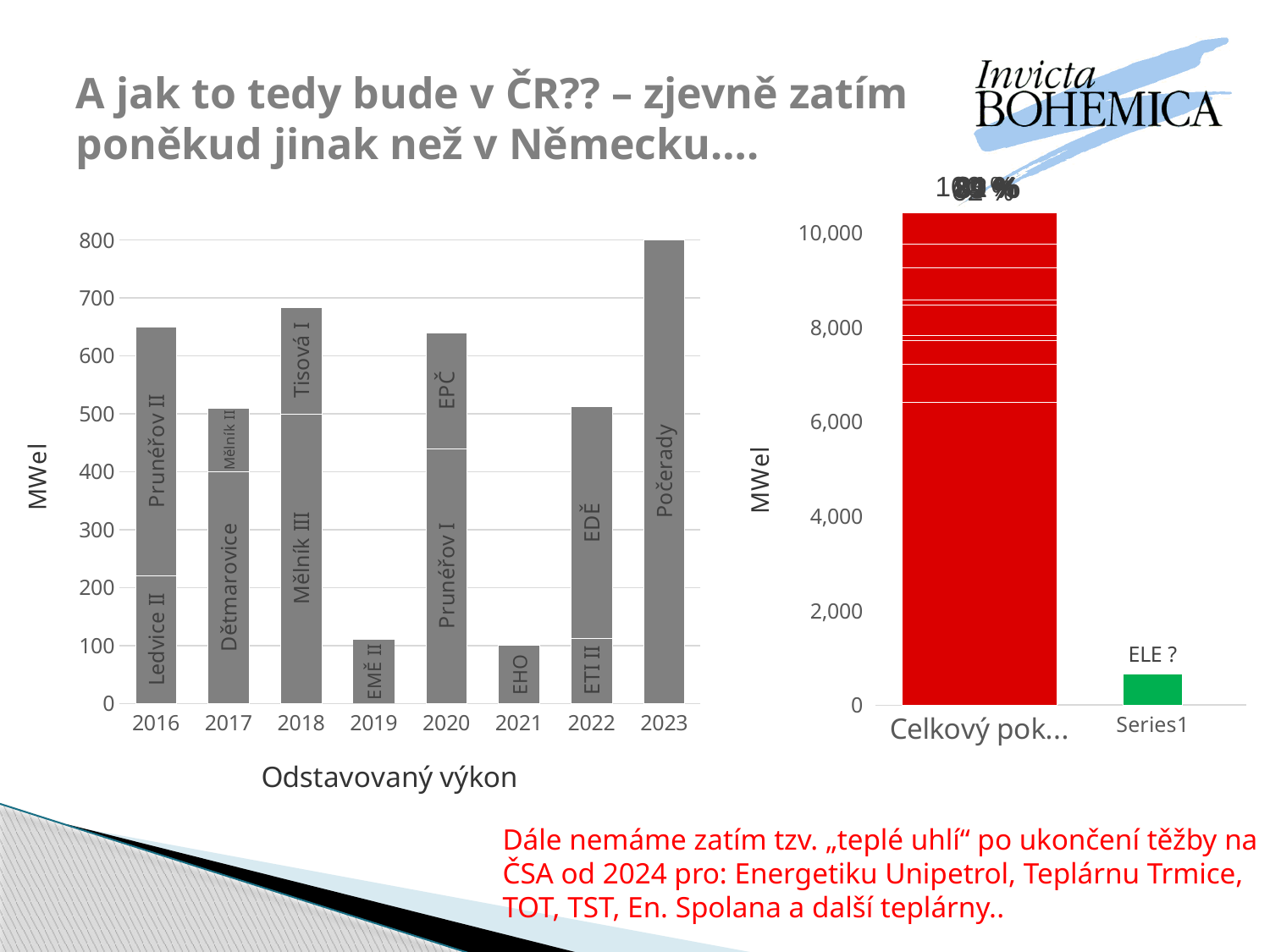
On the left chart 'Odstavovaný výkon', which year has the highest total bar? 2023 On the left chart 'Odstavovaný výkon', is the total value for 2016 greater or less than 600? greater What kind of chart is the left chart titled 'Odstavovaný výkon'? bar chart On the right chart, is the value of the red bar 'Celkový pok...' greater or less than 8,000? greater On the left chart 'Odstavovaný výkon', what is the y-axis label? MWel On the right chart, what text is printed above the green bar? ELE ? On the left chart 'Odstavovaný výkon', which year has the larger total bar, 2016 or 2017? 2016 On the left chart 'Odstavovaný výkon', which plant is labelled on the bar for 2021? EHO On the left chart 'Odstavovaný výkon', how many years are shown on the x axis? 8 On the left chart 'Odstavovaný výkon', is the total value for 2017 greater or less than 600? less On the left chart 'Odstavovaný výkon', which year has the larger total bar, 2020 or 2022? 2020